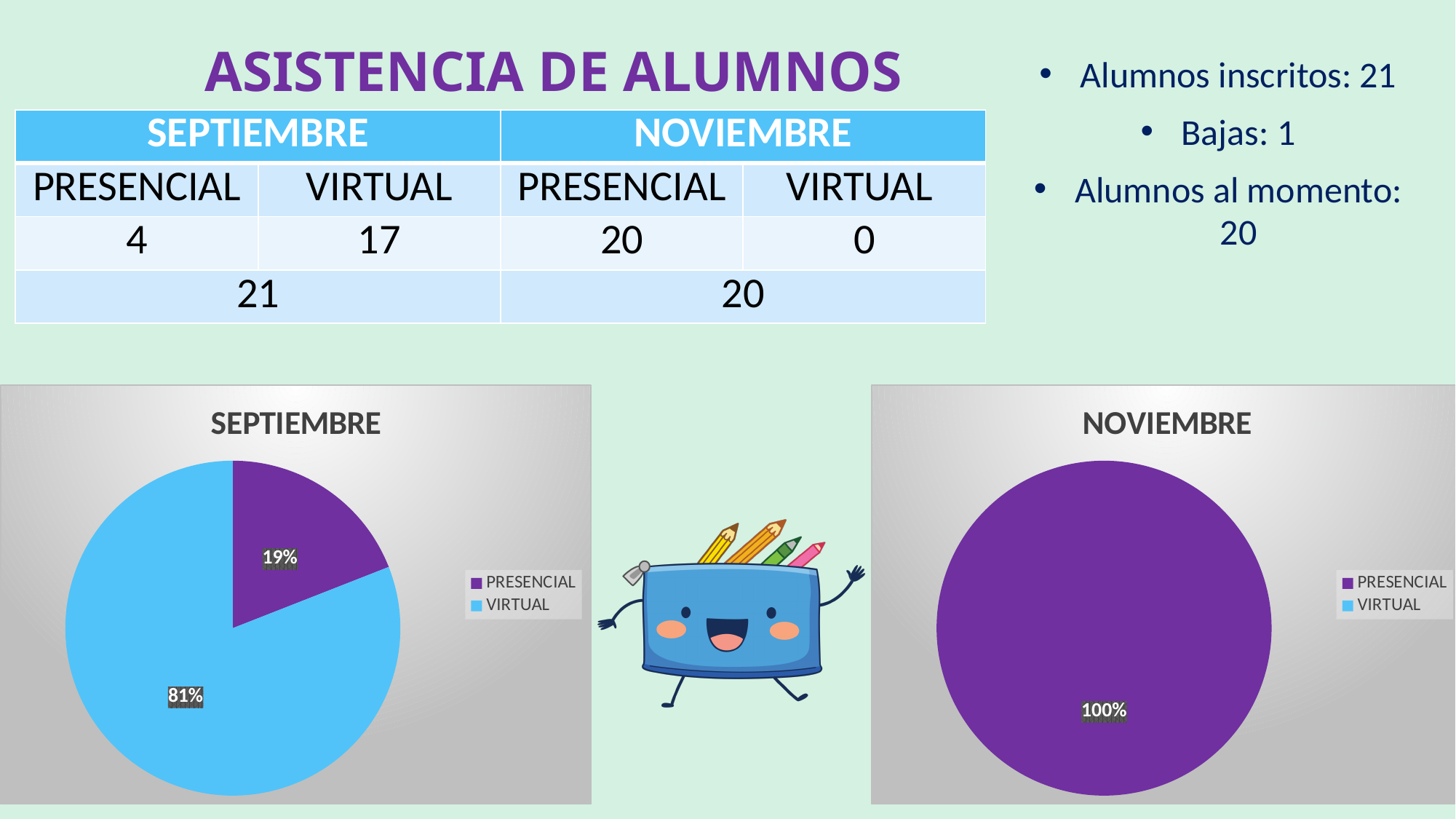
What kind of chart is the NOVIEMBRE chart? Pie chart In the SEPTIEMBRE chart, what share of the pie is PRESENCIAL? 19% In the SEPTIEMBRE chart, what share of the pie is VIRTUAL? 81% What is the title of the pie chart on the right side of the slide? NOVIEMBRE In the SEPTIEMBRE chart, which is larger, PRESENCIAL or VIRTUAL? VIRTUAL In the SEPTIEMBRE chart, what colour is the VIRTUAL slice? Light blue In the SEPTIEMBRE chart, what is the difference in percentage points between the VIRTUAL and PRESENCIAL slices? 62 In the NOVIEMBRE chart, what share of the pie is PRESENCIAL? 100% In the SEPTIEMBRE chart, which category has the smallest slice? PRESENCIAL In the SEPTIEMBRE chart, which category has the largest slice? VIRTUAL How many entries does the legend of the NOVIEMBRE chart list? 2 What kind of chart is the SEPTIEMBRE chart? Pie chart